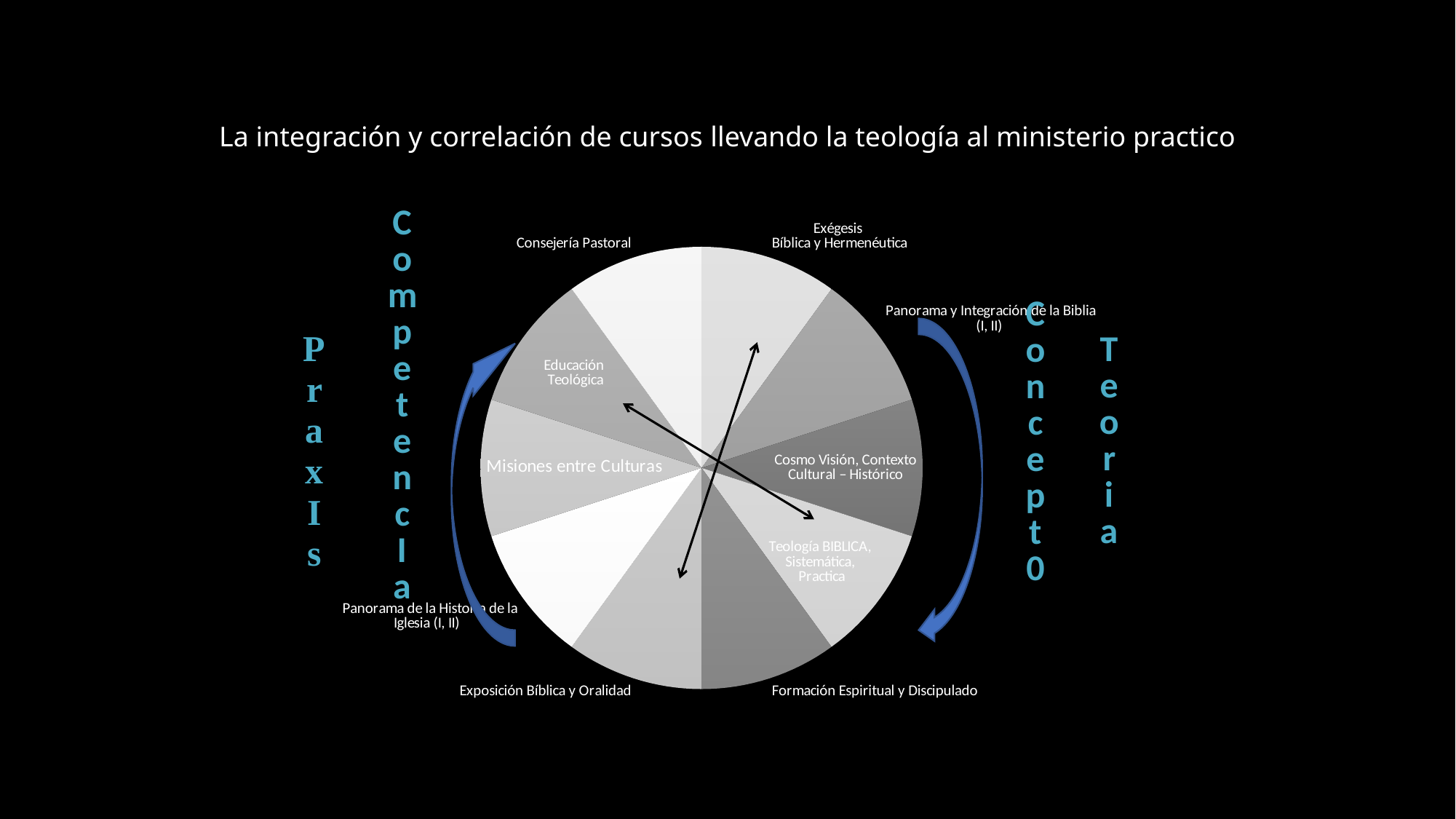
Which slice of the pie chart is labeled Teología BIBLICA, Sistemática, Practica: one on the left half or the right half of the pie? Right half Which slice label is written inside the pie chart on the right side, in the middle? Cosmo Visión, Contexto Cultural – Histórico What is the title of the slide containing the pie chart? La integración y correlación de cursos llevando la teología al ministerio practico How many slices does the pie chart have? 10 Which slice label is written inside the pie chart on the left side, in the middle? Misiones entre Culturas Which slice label appears at the bottom left of the pie chart? Exposición Bíblica y Oralidad Which slice label appears at the top right of the pie chart, next to Consejería Pastoral? Exégesis Bíblica y Hermenéutica What kind of chart is shown on the slide? Pie chart Which slice of the pie chart is labeled directly below Exposición Bíblica y Oralidad's neighbor at the bottom right? Formación Espiritual y Discipulado Which slice label appears at the top left of the pie chart? Consejería Pastoral